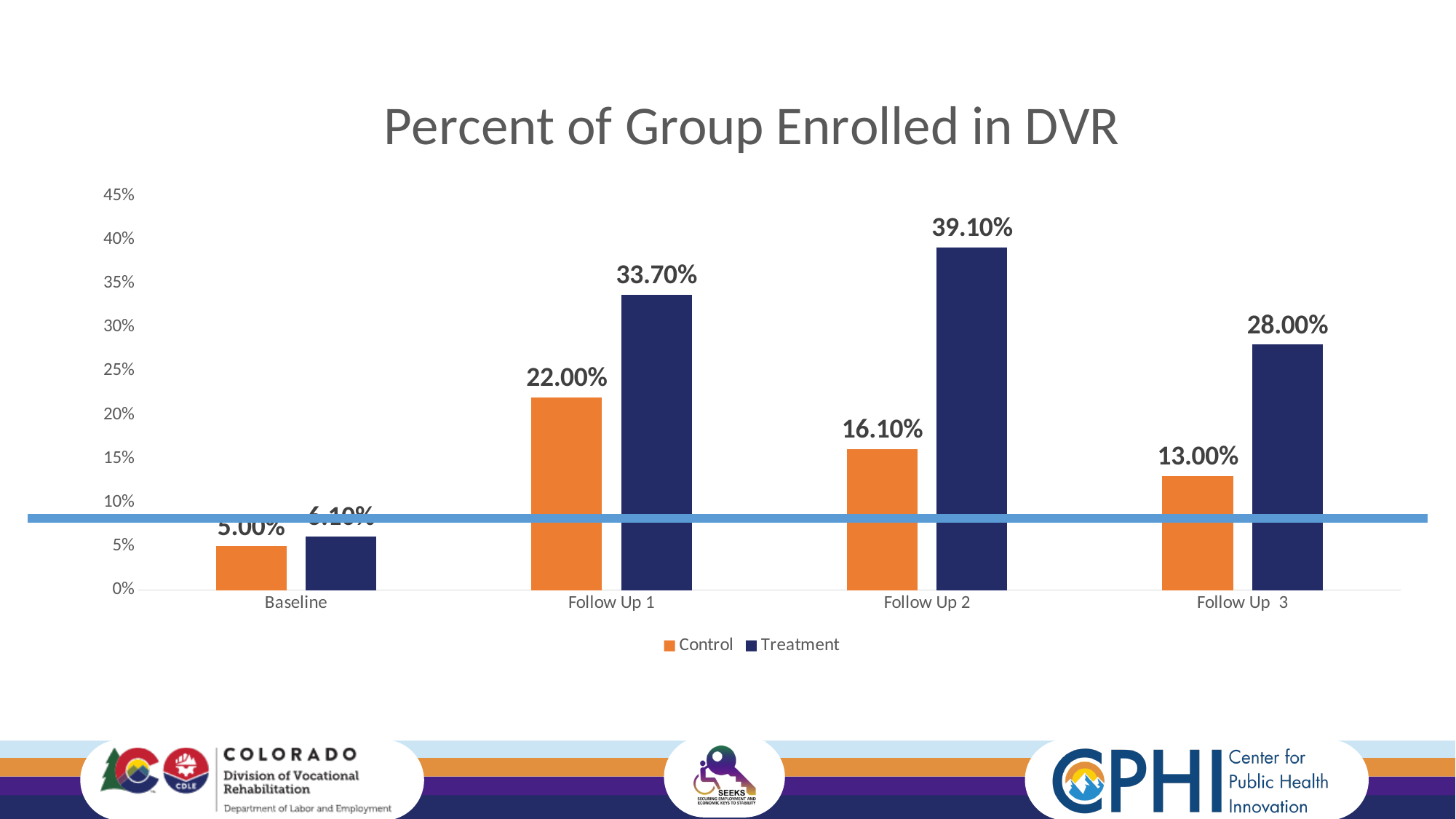
What is the difference between the Treatment and Control values at Follow Up 1? 11.70% What is the Treatment value at Follow Up 2? 39.10% How many time points are shown on the x axis? 4 How many series does the legend list? 2 What is the Control value at Baseline? 5.00% At which time point is the Treatment group's enrollment highest? Follow Up 2 What is the Control value at Follow Up 1? 22.00% Is the Treatment value at Baseline greater or less than 10%? less What is the Treatment value at Follow Up 3? 28.00% What type of chart is shown? Bar chart At which time point is the Control group's enrollment lowest? Baseline Which group has the larger value at Follow Up 3, Control or Treatment? Treatment